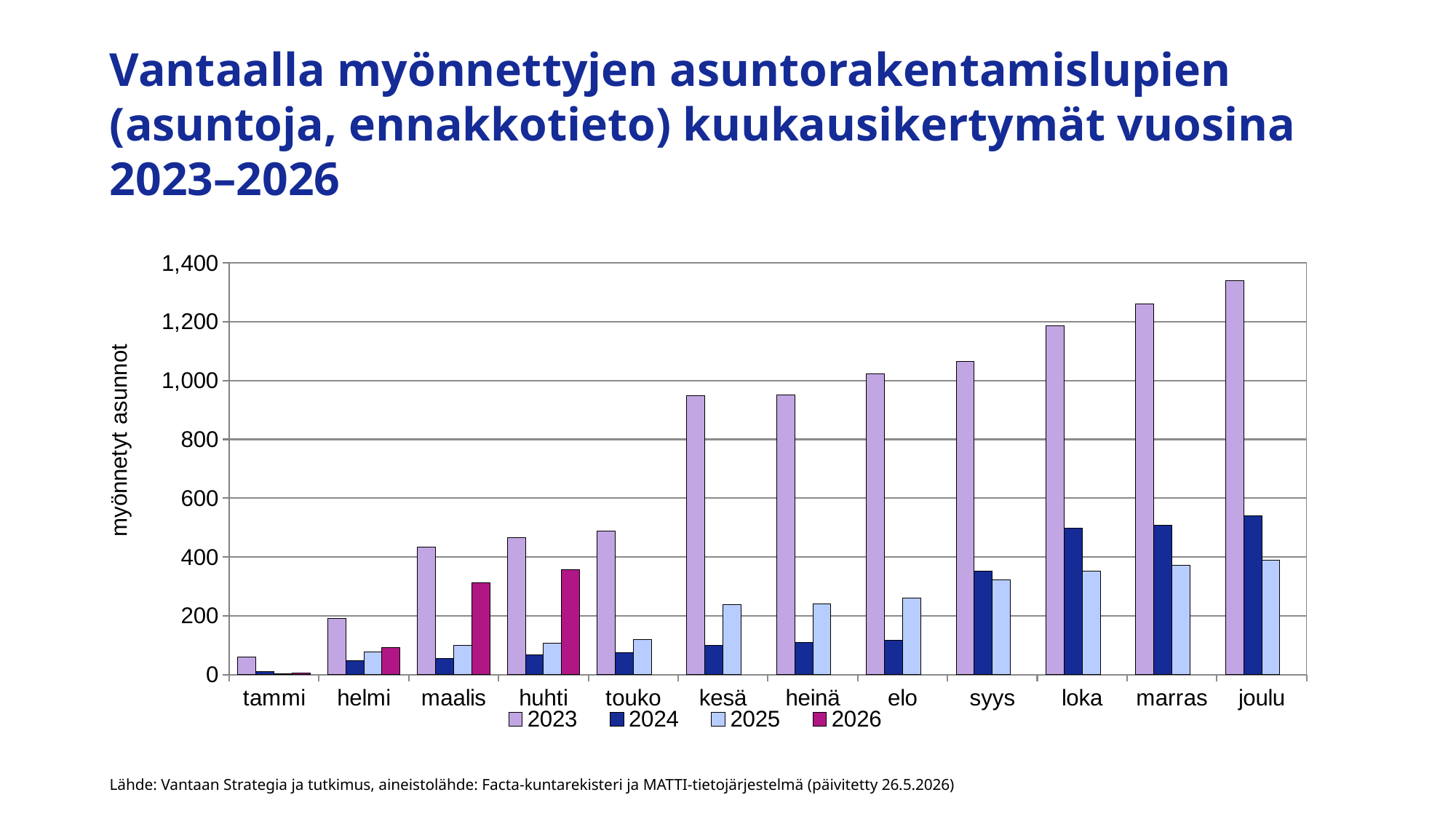
Is the 2023 value for kesä greater or less than 1,000? less Do the 2023 values rise or fall from tammi to joulu? rise How many months are shown on the x axis? 12 For huhti, which is larger: the 2025 value or the 2026 value? 2026 What is the label on the y axis? myönnetyt asunnot Is the 2024 value for loka greater or less than 400? greater Is the 2026 value for maalis greater or less than 200? greater How many series does the legend list? 4 What kind of chart is shown on the slide? bar chart In which month is the 2023 value highest? joulu In which month is the 2023 value lowest? tammi